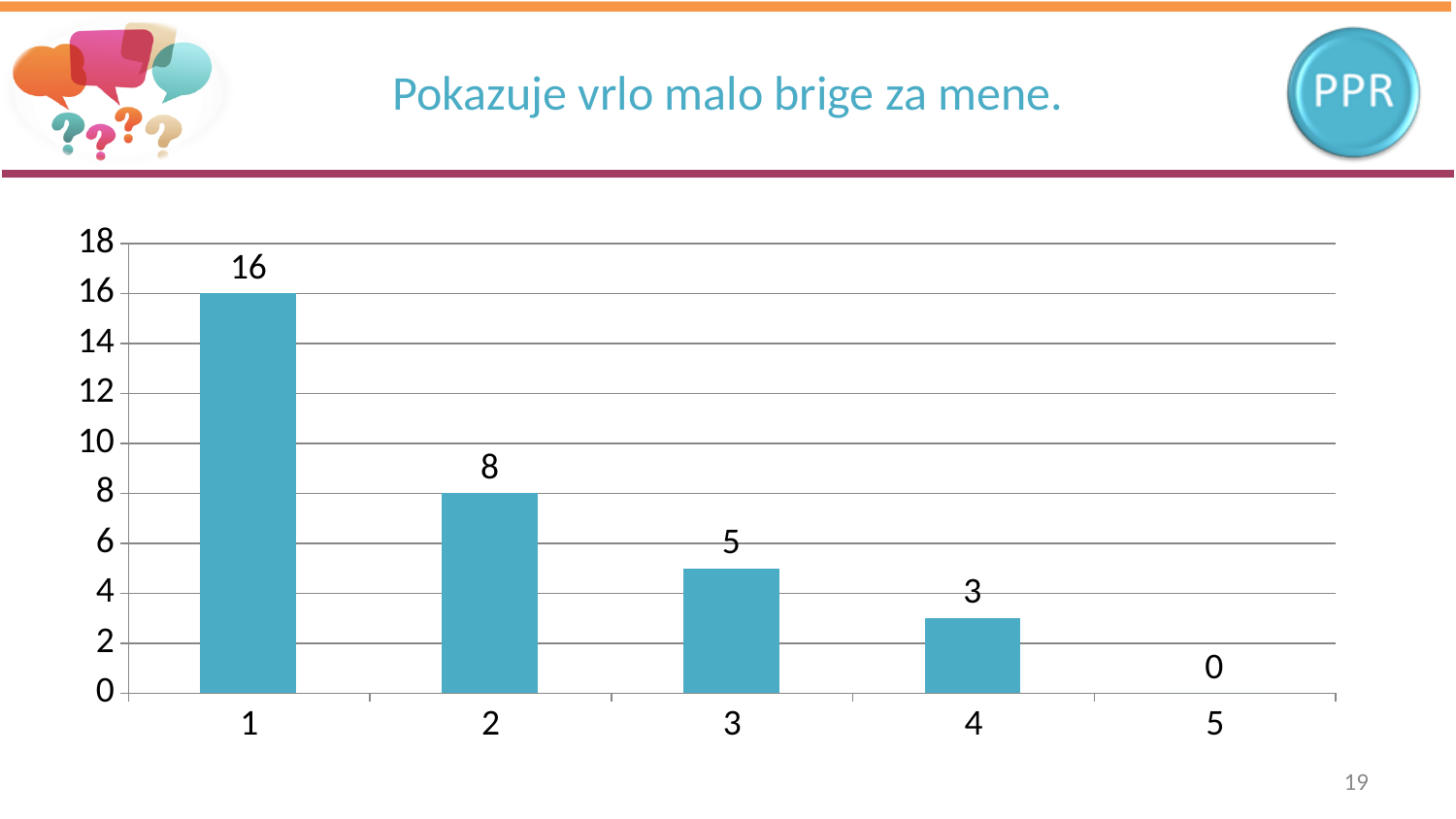
Do the values rise or fall from category 1 to category 5? fall Which category has the highest value? 1 Which is larger, the value for category 2 or the value for category 4? category 2 What is the difference between the values for category 1 and category 2? 8 Is the value for category 1 greater or less than 10? greater What kind of chart is shown on the slide? bar chart How many categories are shown on the x axis? 5 What is the value for category 3? 5 What is the value for category 5? 0 What is the value for category 1? 16 What is the title of the slide? Pokazuje vrlo malo brige za mene. Which category has the lowest value? 5